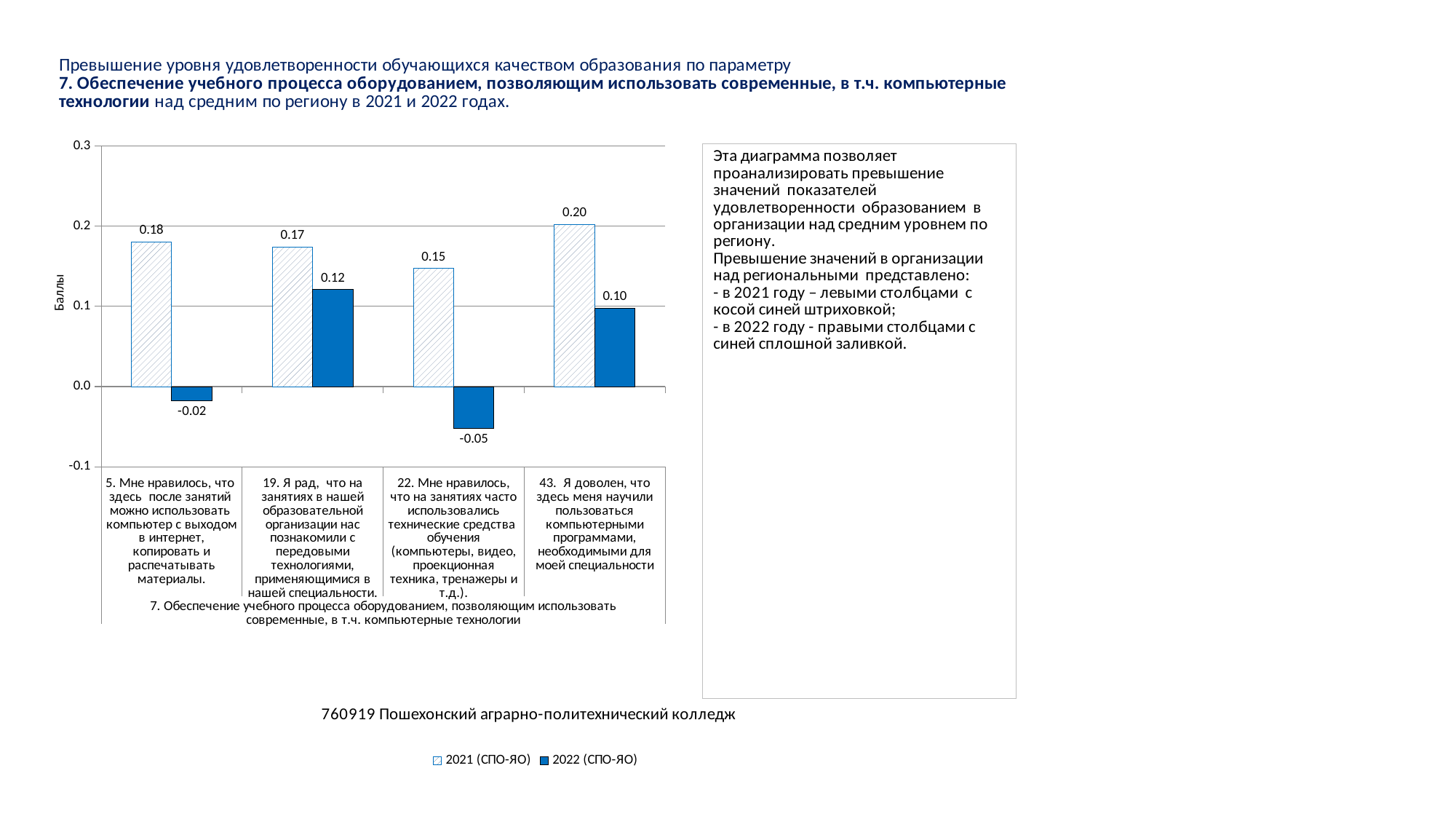
What is the 2022 (СПО-ЯО) value for item 22 ("Мне нравилось, что на занятиях часто использовались технические средства обучения...")? -0.05 What is the difference between the 2021 and 2022 values for item 43? 0.10 Which item has the lowest 2022 (СПО-ЯО) value? 22. Мне нравилось, что на занятиях часто использовались технические средства обучения For item 5, which is larger: the 2021 value or the 2022 value? 2021 Which item has the highest 2021 (СПО-ЯО) value? 43. Я доволен, что здесь меня научили пользоваться компьютерными программами, необходимыми для моей специальности How many series does the chart legend list? 2 What type of chart is shown on the slide? Bar chart What is the 2021 (СПО-ЯО) value for item 5 ("Мне нравилось, что здесь после занятий можно использовать компьютер...")? 0.18 What is the 2022 (СПО-ЯО) value for item 19 ("Я рад, что на занятиях в нашей образовательной организации нас познакомили с передовыми технологиями...")? 0.12 Is the 2021 value for item 43 greater or less than 0.1? greater How many items (categories) are shown on the x axis of the chart? 4 What is the label of the vertical axis of the chart? Баллы